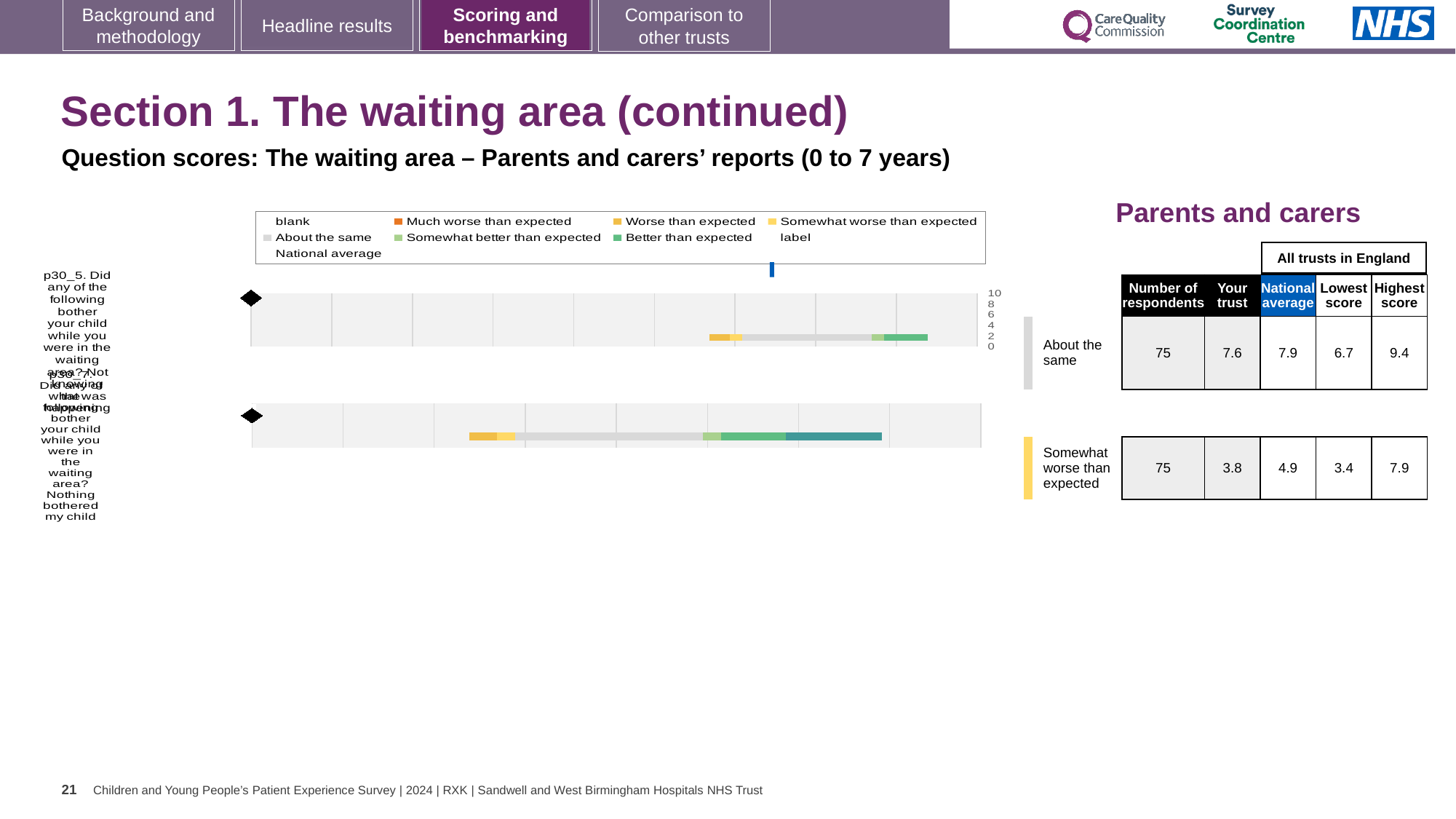
What is the 'Your trust' score for question p30_5 (Did any of the following bother your child while you were in the waiting area? Not knowing what was happening)? 7.6 How many entries does the chart legend list? 9 What is the heading shown above the table to the right of the chart? Parents and carers What is the difference between the highest score and the lowest score for question p30_5? 2.7 Which question has the higher 'Your trust' score, p30_5 or p30_7? p30_5 What is the 'Your trust' score for question p30_7 (Did any of the following bother your child while you were in the waiting area? Nothing bothered my child)? 3.8 Which benchmarking category is question p30_7 rated as? Somewhat worse than expected What is the national average score for question p30_5? 7.9 What is the difference between the national average and the 'Your trust' score for question p30_7? 1.1 What kind of chart is shown on the slide? Bar chart How many questions (bars) are plotted in the chart? 2 How many respondents answered question p30_7? 75